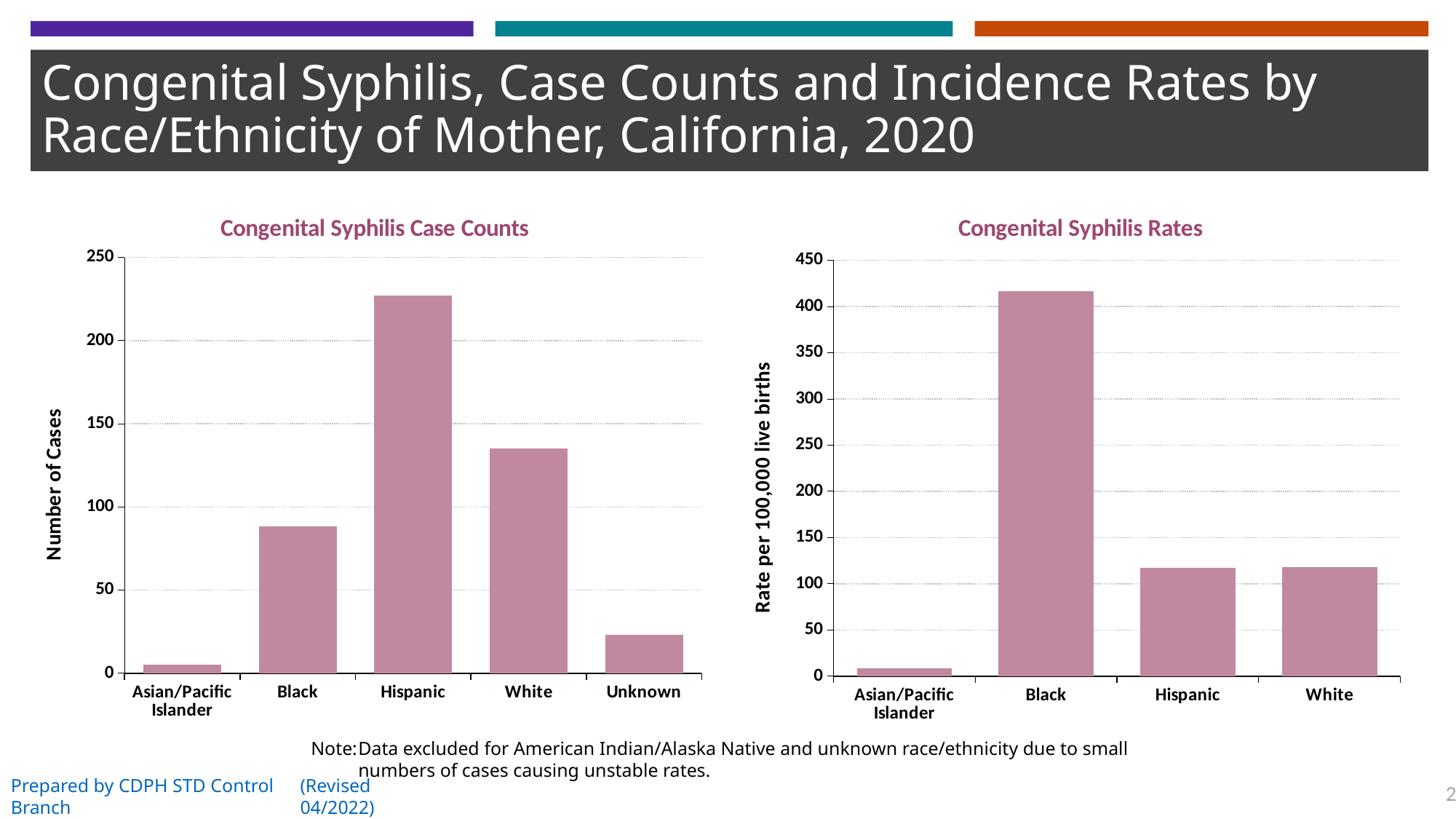
In the Congenital Syphilis Rates chart, which race/ethnicity has the highest rate? Black In the Congenital Syphilis Case Counts chart, is the value for Black greater or less than 100? less How many race/ethnicity categories are shown in the Congenital Syphilis Rates chart? 4 In the Congenital Syphilis Case Counts chart, which is larger, the value for White or the value for Black? White In the Congenital Syphilis Rates chart, is the value for Black greater or less than 400? greater In the Congenital Syphilis Case Counts chart, which race/ethnicity has the lowest number of cases? Asian/Pacific Islander In the Congenital Syphilis Rates chart, is the value for Hispanic greater or less than 150? less In the Congenital Syphilis Rates chart, which race/ethnicity has the lowest rate? Asian/Pacific Islander How many race/ethnicity categories are shown in the Congenital Syphilis Case Counts chart? 5 In the Congenital Syphilis Case Counts chart, which race/ethnicity has the highest number of cases? Hispanic What is the y-axis label of the Congenital Syphilis Rates chart? Rate per 100,000 live births